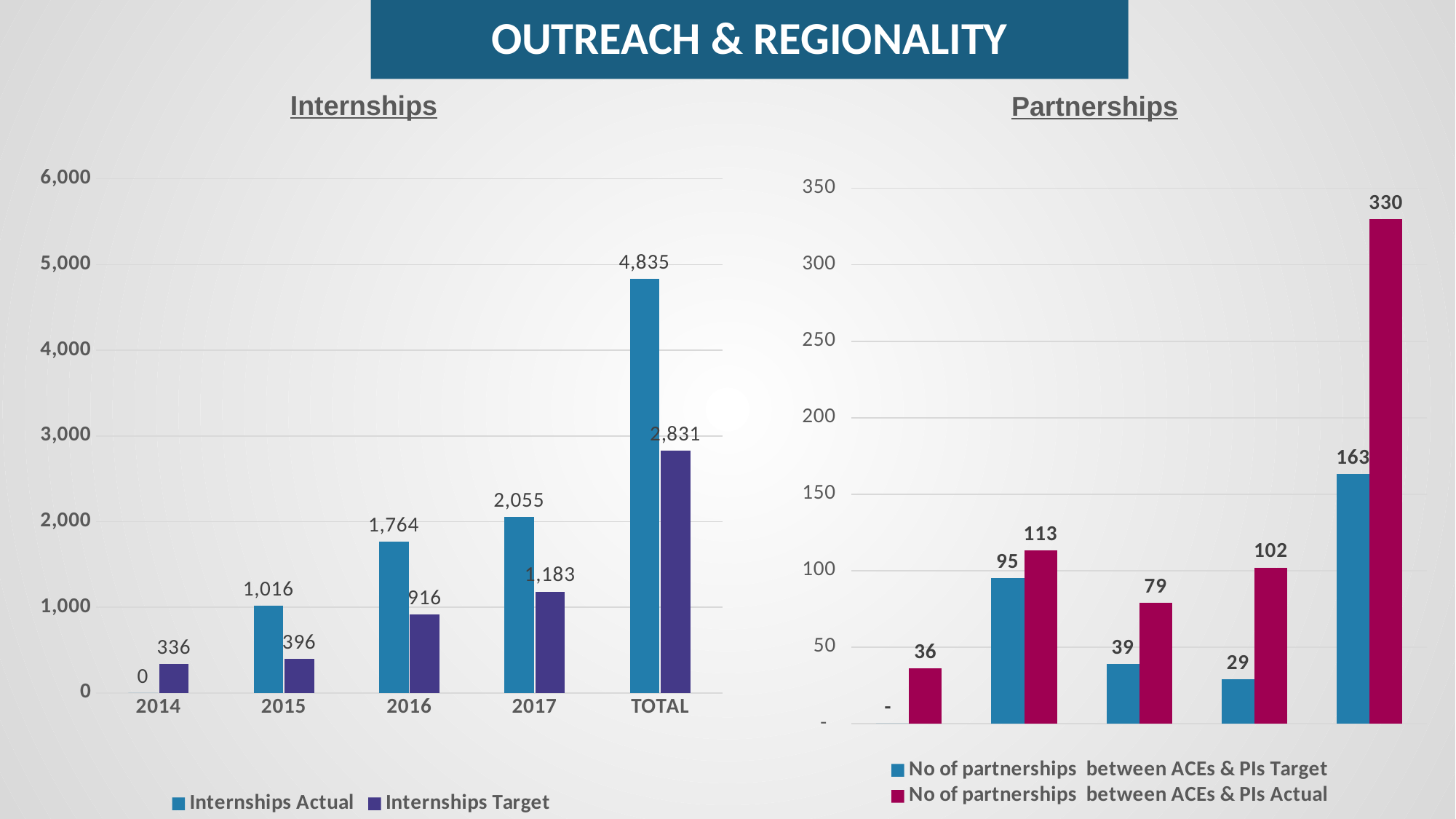
What type of chart is the Partnerships chart? Bar chart In the Partnerships chart, what are the two series listed in the legend? No of partnerships between ACEs & PIs Target; No of partnerships between ACEs & PIs Actual In the Internships chart, what is the Internships Target value for TOTAL? 2,831 How many categories are shown on the x axis of the Internships chart? 5 In the Internships chart, which year (excluding TOTAL) has the highest Internships Actual value? 2017 In the Internships chart, what is the Internships Actual value for 2014? 0 In the Internships chart, which is larger for 2016: Internships Actual or Internships Target? Internships Actual In the Internships chart, what is the Internships Actual value for 2017? 2,055 In the Partnerships chart, what is the highest value shown for the No of partnerships between ACEs & PIs Actual series? 330 How many series does the legend of the Internships chart list? 2 In the Internships chart, what is the difference between Internships Actual and Internships Target for 2015? 620 In the Internships chart, what is the Internships Target value for 2016? 916